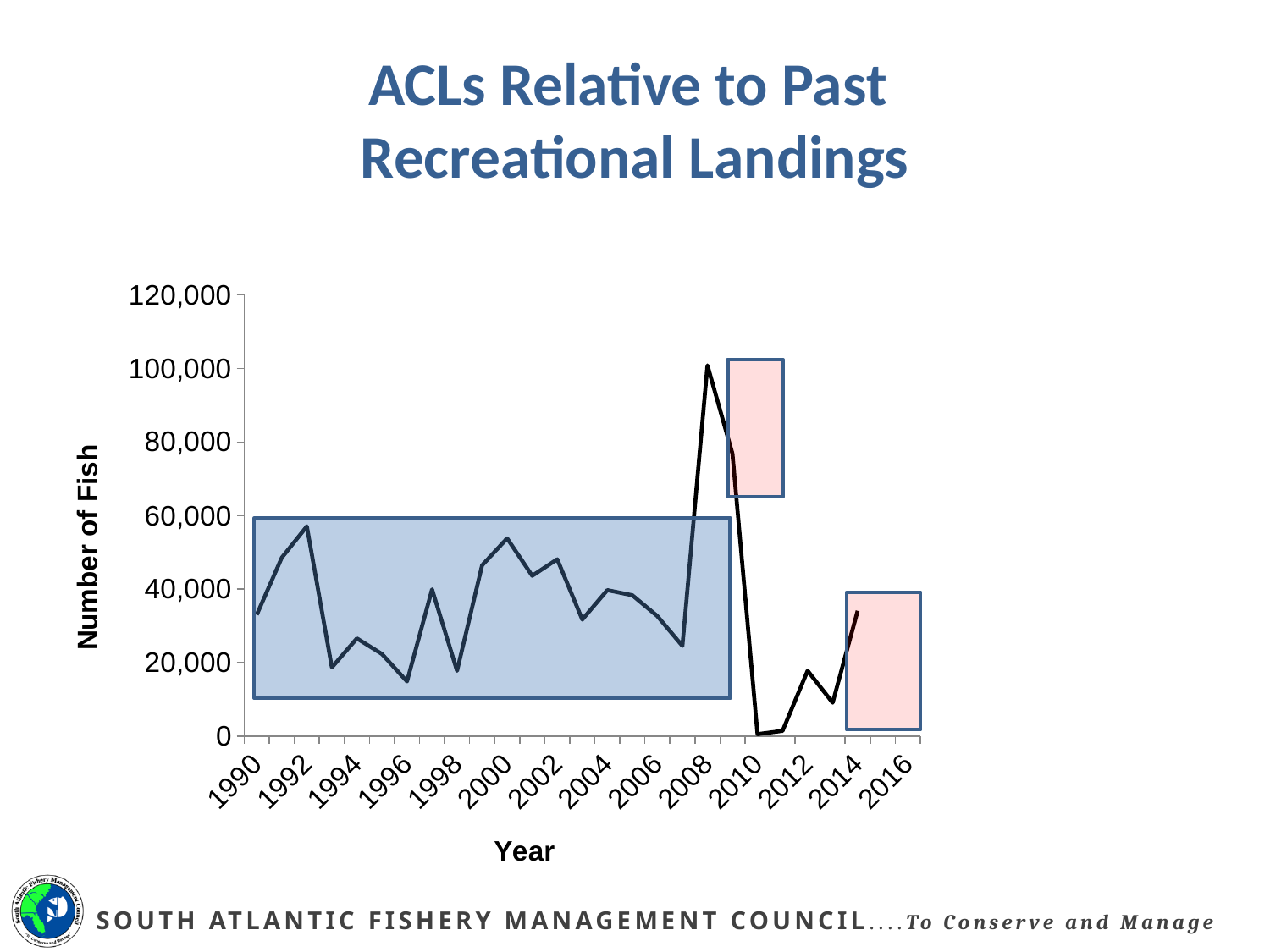
What is the title of the chart on the slide? ACLs Relative to Past Recreational Landings Is the value for 2010 greater or less than 20,000? less What is the label on the vertical axis of the chart? Number of Fish What kind of chart is shown on the slide? Line chart Does the line rise or fall between 2008 and 2010? Fall Is the value for 2000 greater or less than 40,000? greater In which year does the line reach its highest value? 2008 Is the value for 1990 greater or less than 20,000? greater How many year labels are shown on the x axis? 14 Which year has the larger value, 1992 or 1994? 1992